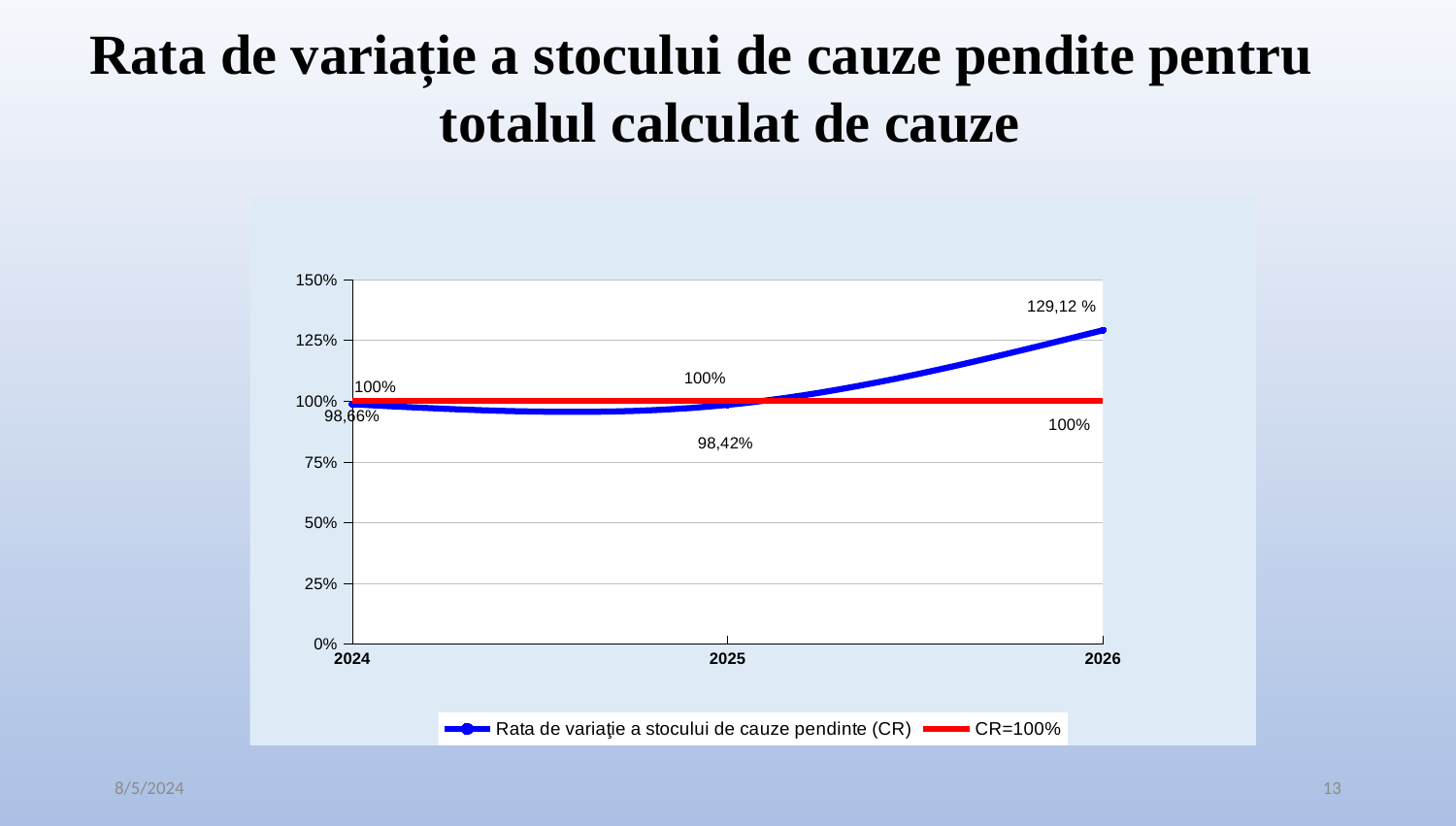
What is the value of 'Rata de variație a stocului de cauze pendinte (CR)' for 2025? 98,42% Which is larger in 2026: 'Rata de variație a stocului de cauze pendinte (CR)' or 'CR=100%'? Rata de variație a stocului de cauze pendinte (CR) What is the value of 'Rata de variație a stocului de cauze pendinte (CR)' for 2026? 129,12 % Is the value for 'Rata de variație a stocului de cauze pendinte (CR)' in 2026 greater or less than 125%? greater What is the value of 'Rata de variație a stocului de cauze pendinte (CR)' for 2024? 98,66% What colour is the 'CR=100%' line? red In which year is 'Rata de variație a stocului de cauze pendinte (CR)' lowest? 2025 How many years are shown on the x axis? 3 In which year is 'Rata de variație a stocului de cauze pendinte (CR)' highest? 2026 What is the value of the 'CR=100%' series for 2025? 100% How many series does the legend list? 2 What type of chart is shown on the slide? line chart